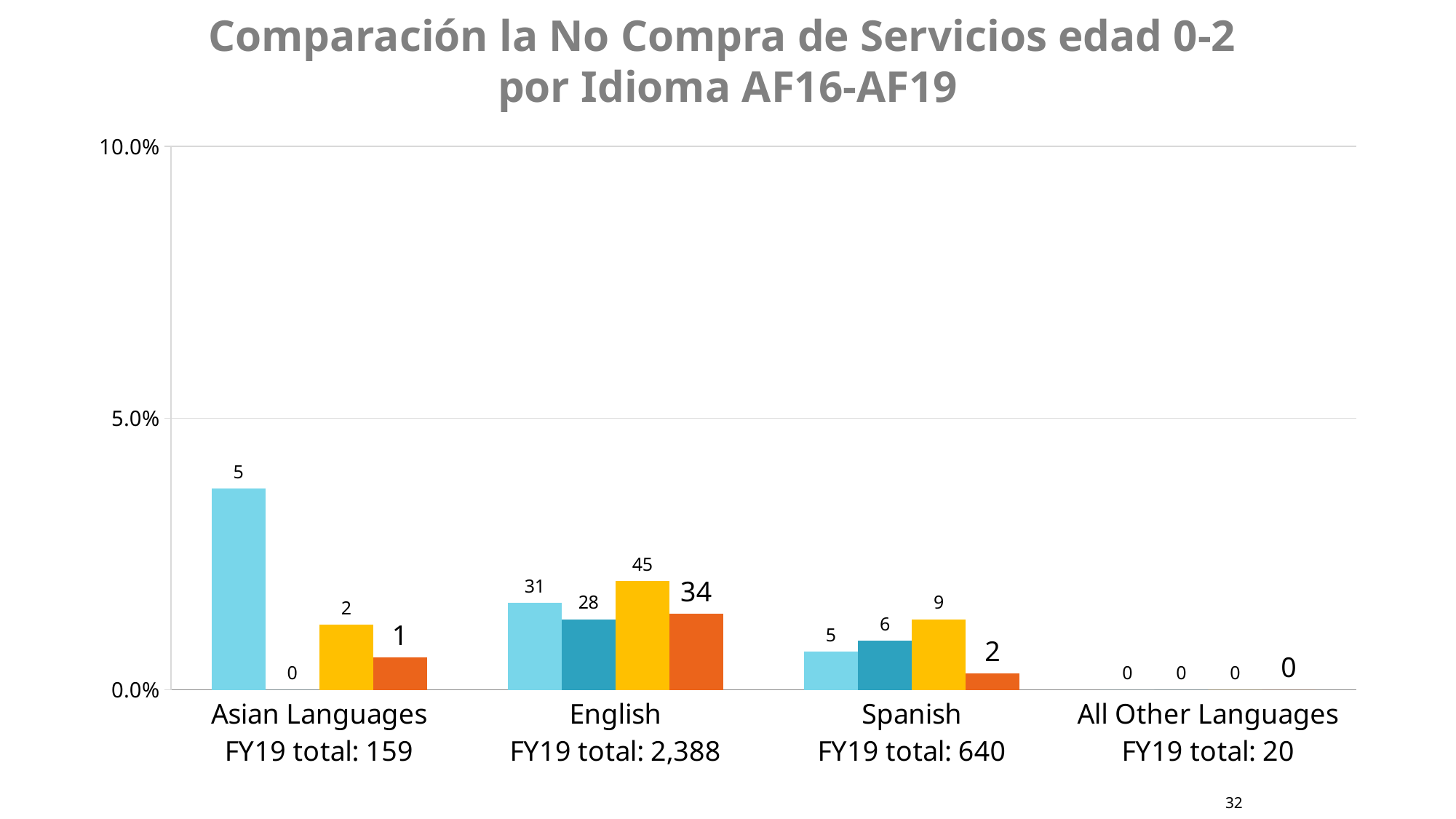
Within the English category, which coloured bar is the tallest? yellow Which is taller: the yellow bar for English or the yellow bar for Spanish? English How many language categories are shown on the x axis? 4 Is the light blue bar for Asian Languages greater or less than 5.0%? less What number is printed above the orange bar for Spanish? 2 What number is printed above the light blue bar for Asian Languages? 5 What number is printed above the teal bar for English? 28 How many bars are plotted for the English category? 4 Which language category has the tallest bar in the chart? Asian Languages What number is printed above the yellow bar for English? 45 What kind of chart is shown on the slide? bar chart What FY19 total is shown under the English category label? 2,388